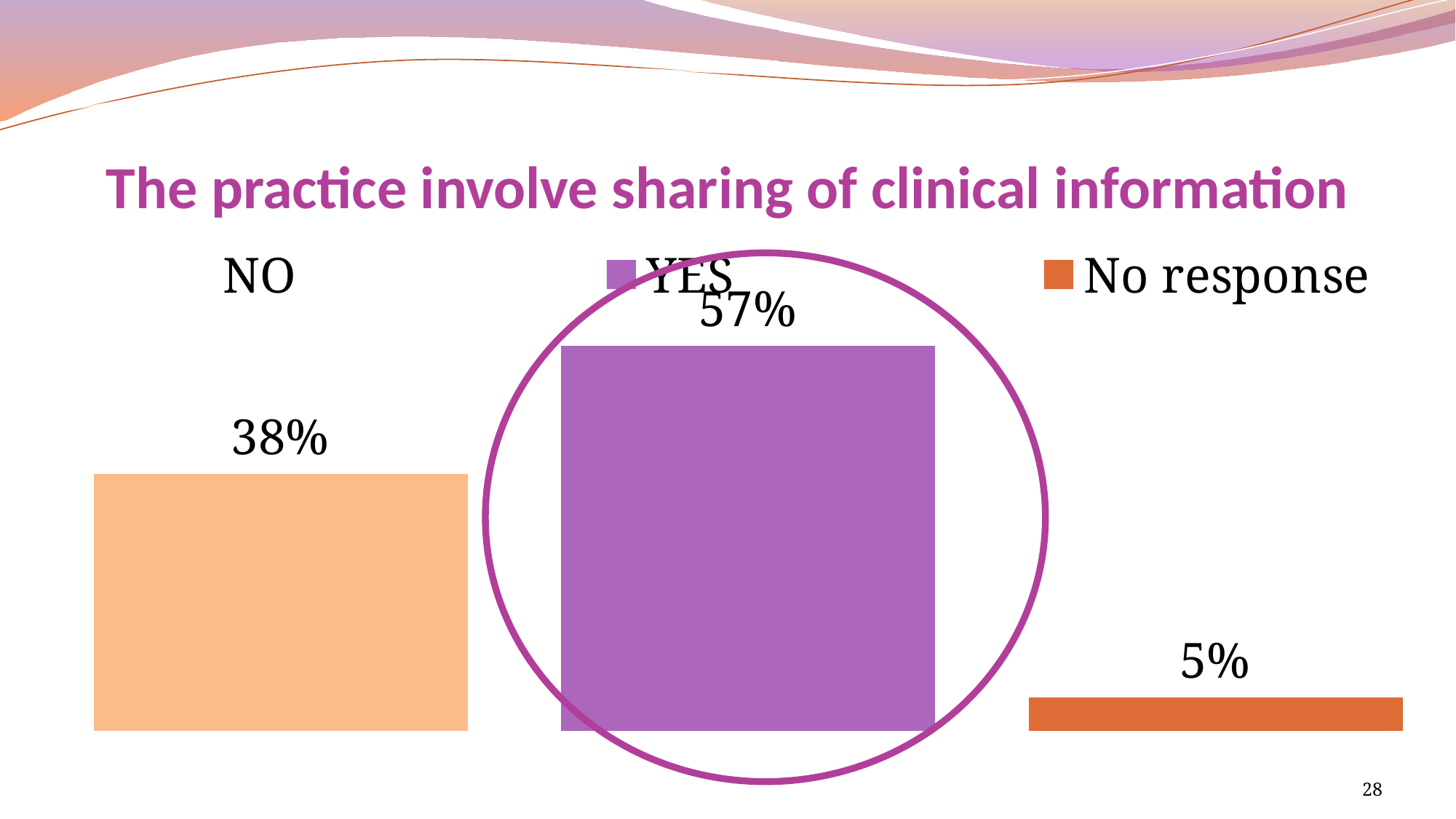
What is the value for YES? 57% What is the value for NO? 38% Which category has the lowest value? No response What kind of chart is shown on the slide? Bar chart What is the title of the slide? The practice involve sharing of clinical information How many entries does the legend list? 3 Which is larger, the value for NO or the value for No response? NO Which category has the highest value? YES What is the difference between the YES and NO values? 19% What is the difference between the NO and No response values? 33% How many categories are shown in the chart? 3 What is the value for No response? 5%